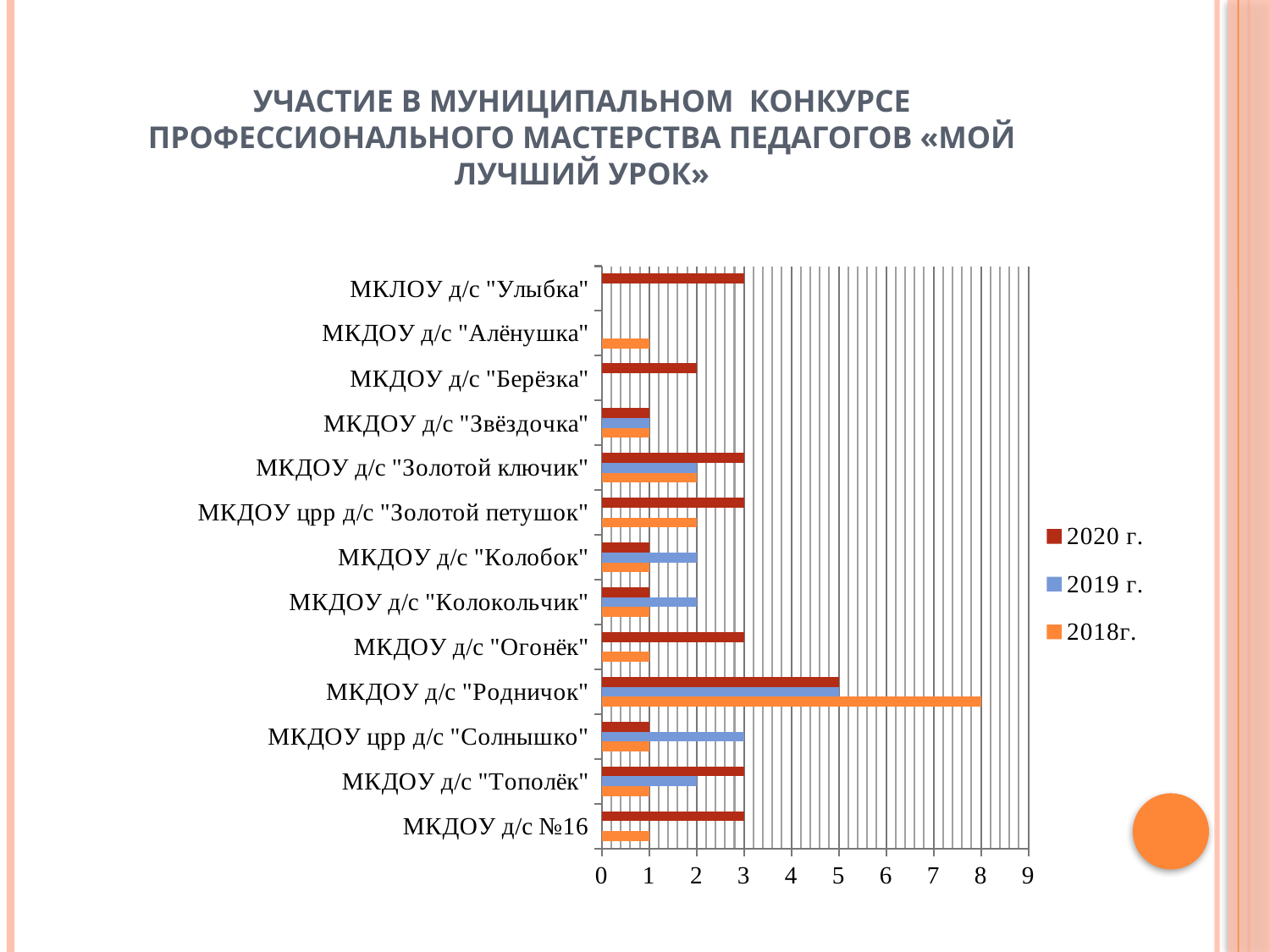
What is the value for МКДОУ д/с "Родничок" in the 2018г. series? 8 What kind of chart is shown on the slide? bar chart How many categories (institutions) are shown on the chart? 13 What is the value for МКДОУ д/с "Берёзка" in the 2020 г. series? 2 Which series is shown in orange in the legend? 2018г. Which institution has the highest value in the 2018г. series? МКДОУ д/с "Родничок" What is the difference between the 2018г. and 2020 г. values for МКДОУ д/с "Родничок"? 3 Is the 2018г. value for МКДОУ д/с "Родничок" greater or less than 6? greater Which is larger for МКДОУ д/с "Тополёк": the 2020 г. value or the 2018г. value? 2020 г. What is the value for МКДОУ д/с "Родничок" in the 2020 г. series? 5 What is the value for МКДОУ црр д/с "Солнышко" in the 2019 г. series? 3 How many series does the legend list? 3